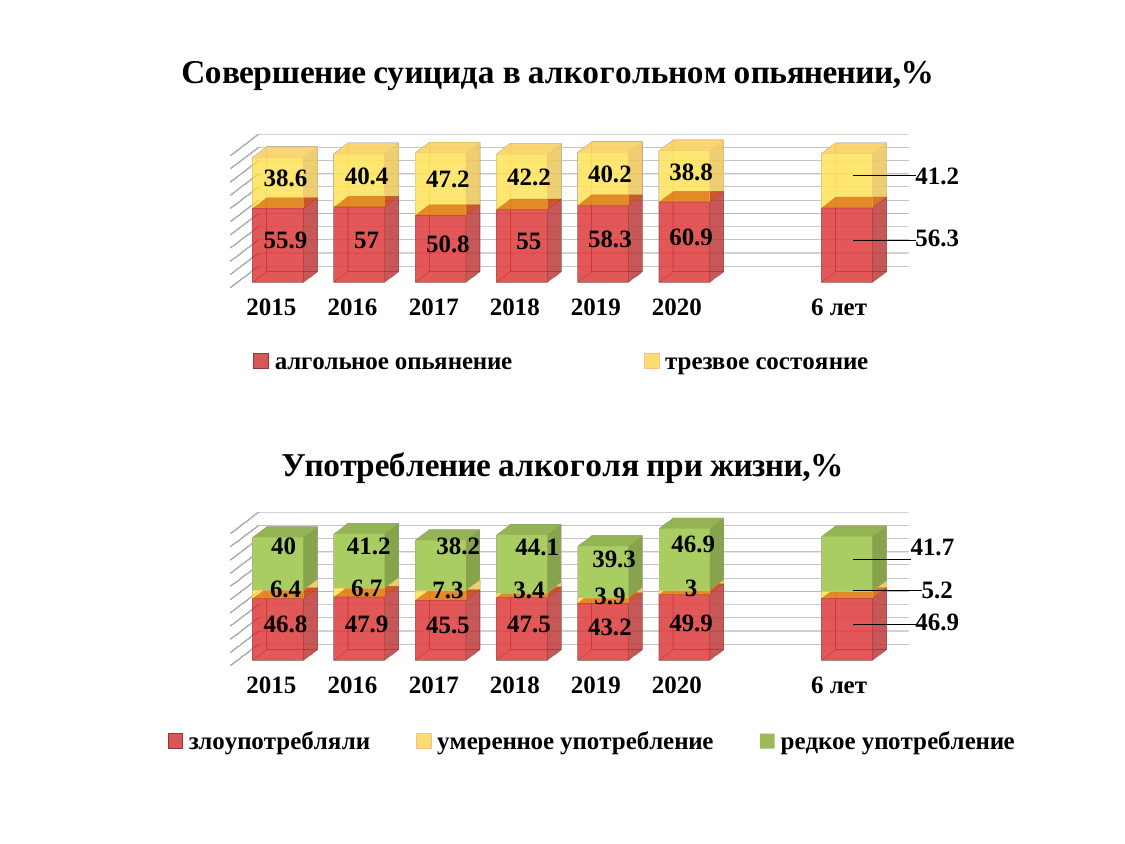
In the top chart 'Совершение суицида в алкогольном опьянении,%', how many series does the legend list? 2 What kind of chart is the bottom chart 'Употребление алкоголя при жизни,%'? Stacked bar chart In the top chart 'Совершение суицида в алкогольном опьянении,%', what is the value for 'алгольное опьянение' in 2020? 60.9 In the bottom chart 'Употребление алкоголя при жизни,%', which year has the lowest value for 'злоупотребляли'? 2019 In the top chart 'Совершение суицида в алкогольном опьянении,%', what is the value for 'трезвое состояние' in 2017? 47.2 In the top chart 'Совершение суицида в алкогольном опьянении,%', what is the difference between the 'алгольное опьянение' values for 2019 and 2017? 7.5 In the top chart 'Совершение суицида в алкогольном опьянении,%', which year has the highest value for 'алгольное опьянение'? 2020 In the top chart 'Совершение суицида в алкогольном опьянении,%', which year has the lowest value for 'трезвое состояние'? 2015 In the bottom chart 'Употребление алкоголя при жизни,%', what is the value for 'умеренное употребление' in 2018? 3.4 In the bottom chart 'Употребление алкоголя при жизни,%', is the 'редкое употребление' value larger in 2020 or in 2017? 2020 In the bottom chart 'Употребление алкоголя при жизни,%', what is the value for 'редкое употребление' for '6 лет'? 41.7 In the bottom chart 'Употребление алкоголя при жизни,%', what is the total of the stacked bar for 2016? 95.8